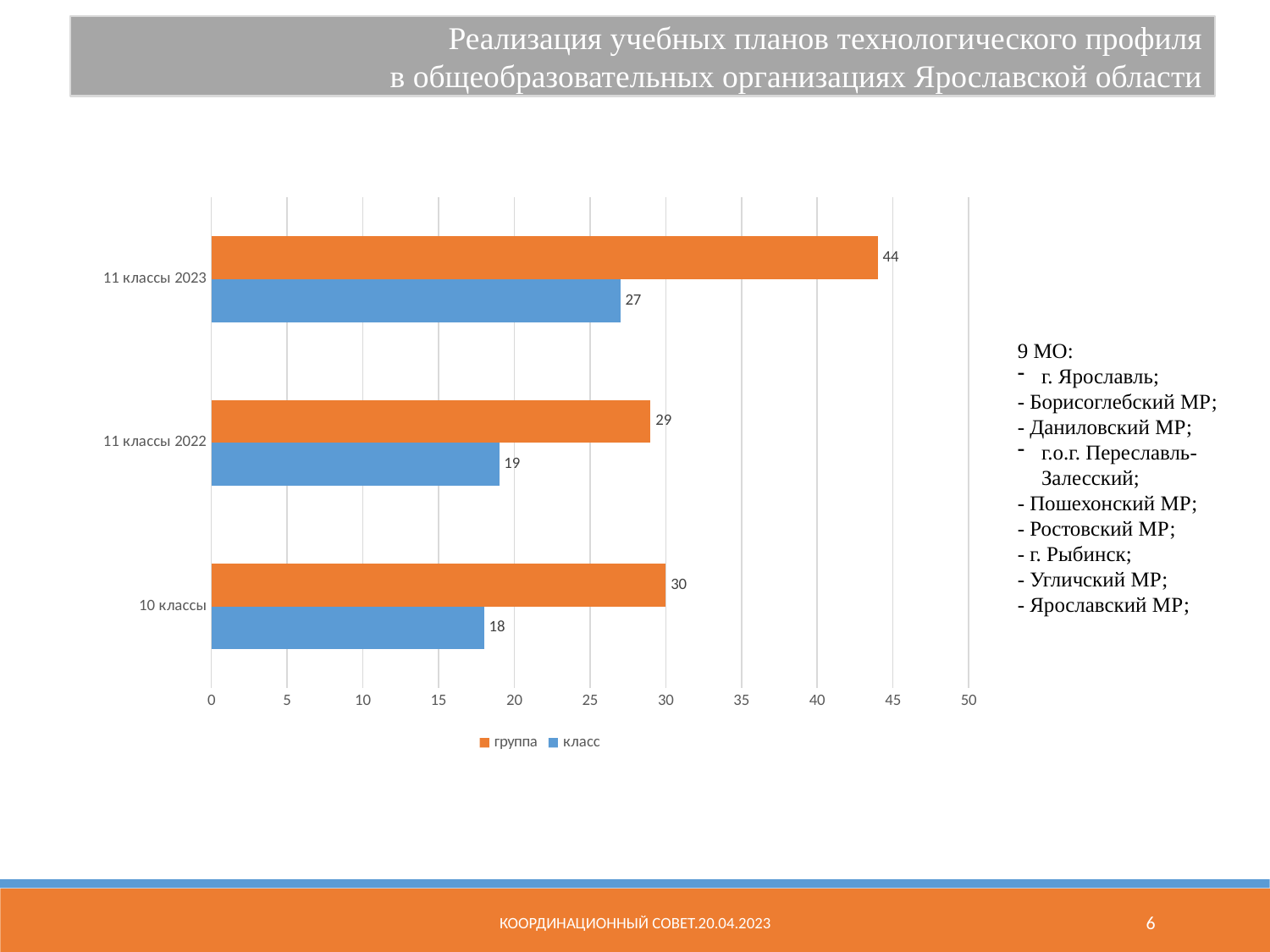
How many series does the legend list? 2 Which category has the lowest value for "класс"? 10 классы Which is larger: the "группа" value for "10 классы" or the "группа" value for "11 классы 2022"? 10 классы What is the difference between the "группа" values for "11 классы 2023" and "11 классы 2022"? 15 What is the value for "группа" in the "11 классы 2023" category? 44 Which category has the highest value for "группа"? 11 классы 2023 What kind of chart is shown on the slide? bar chart What is the value for "класс" in the "11 классы 2022" category? 19 What is the value for "класс" in the "10 классы" category? 18 How many categories are shown on the chart? 3 Is the value for "класс" in "11 классы 2023" greater or less than 25? greater What is the difference between the "группа" and "класс" values for "11 классы 2023"? 17